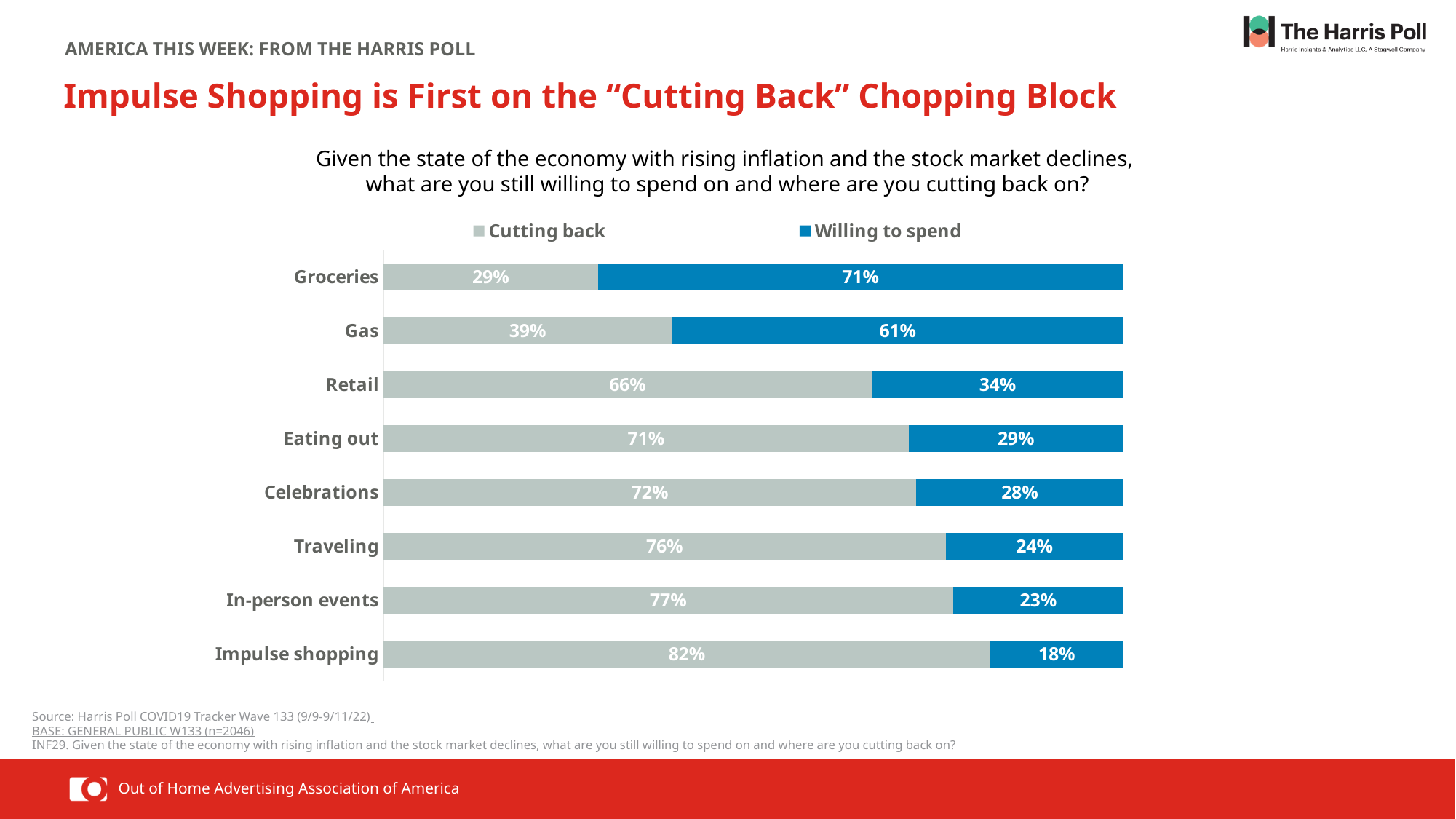
What kind of chart is shown on the slide? Stacked bar chart What percentage of respondents are cutting back on Impulse shopping? 82% Which is larger: the 'Willing to spend' value for Gas or for Retail? Gas What percentage of respondents are still willing to spend on Groceries? 71% Which category has the lowest 'Cutting back' percentage? Groceries Which category has the lowest 'Willing to spend' percentage? Impulse shopping How many spending categories are shown in the chart? 8 What is the difference between the 'Cutting back' percentages for Retail and Gas? 27% How many series does the legend list? 2 What is the total of the stacked bar for In-person events? 100% What is the 'Willing to spend' value for Traveling? 24% Which category has the highest 'Cutting back' percentage? Impulse shopping